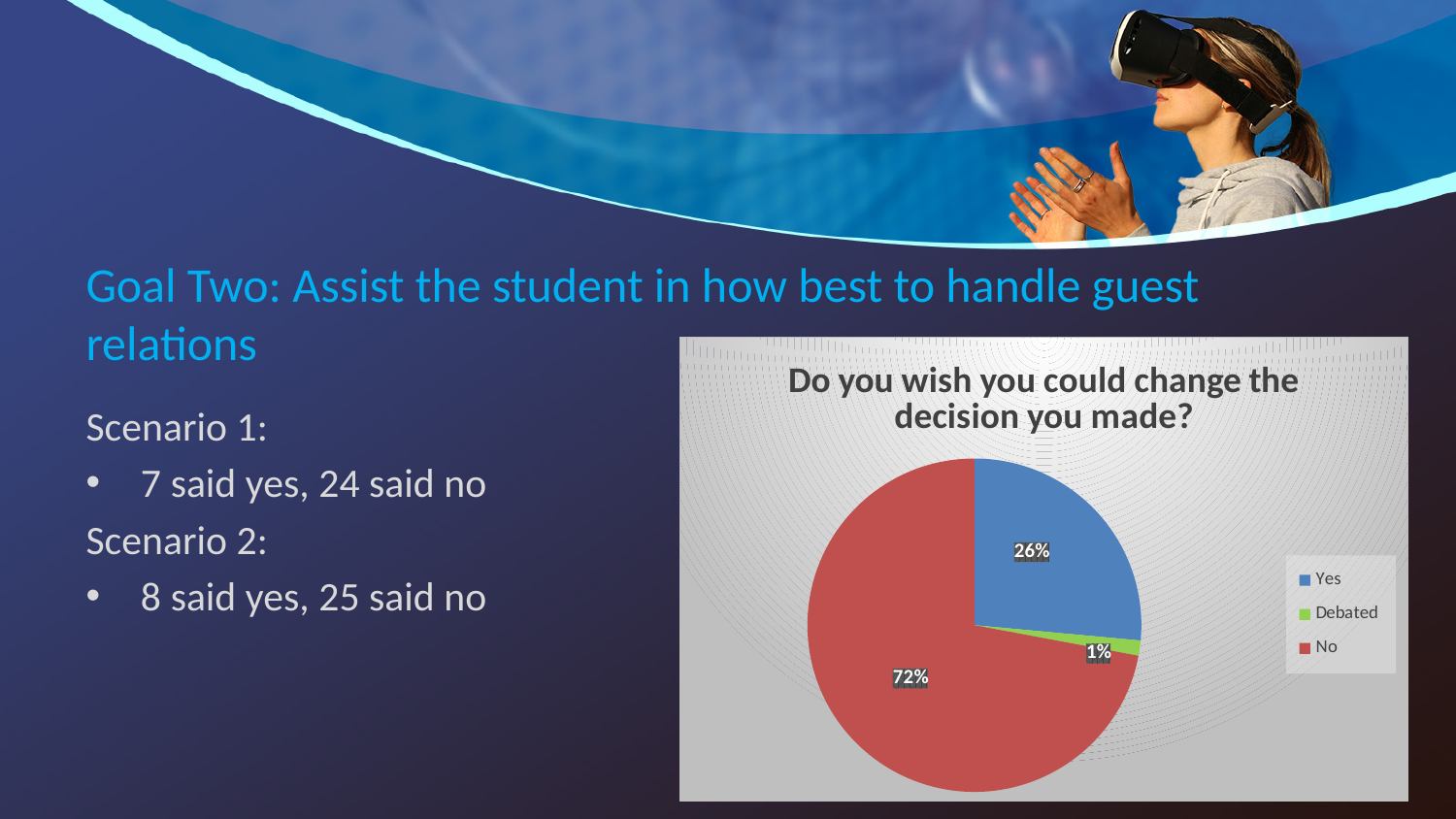
What colour is the "No" slice? red What percentage of the pie is the "Yes" slice? 26% Which category has the largest share of the pie? No Which slice is larger, "Yes" or "Debated"? Yes Which category has the smallest share of the pie? Debated What percentage of the pie is the "No" slice? 72% What kind of chart is shown on the slide? pie chart What is the title of the chart? Do you wish you could change the decision you made? What is the difference in percentage points between the "No" slice and the "Yes" slice? 46 How many categories does the legend list? 3 What percentage of the pie is the "Debated" slice? 1%